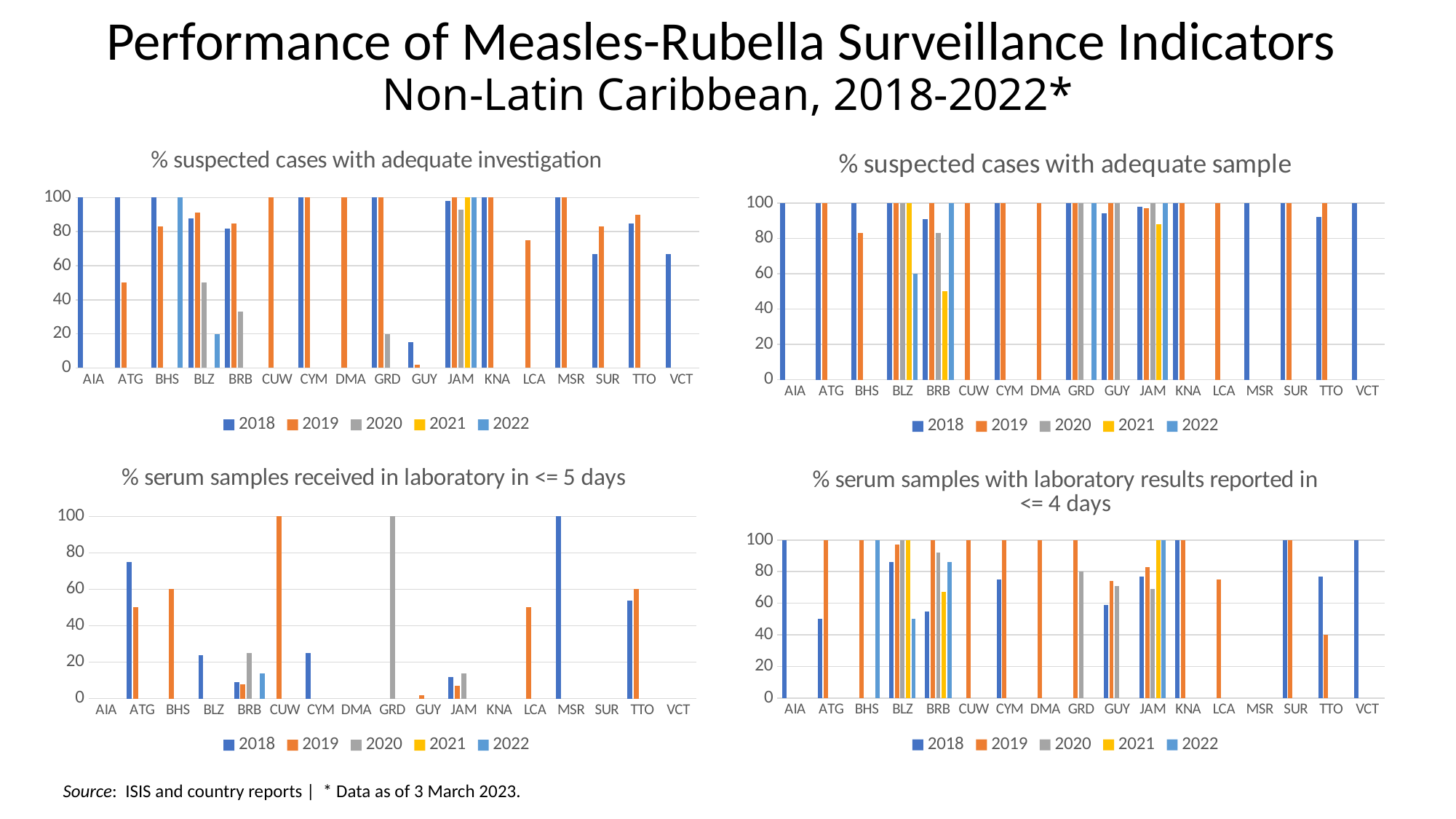
In "% serum samples received in laboratory in <= 5 days", what is the value for CUW in 2019? 100 In "% suspected cases with adequate investigation", what is the value for AIA in 2018? 100 In "% serum samples with laboratory results reported in <= 4 days", which country has the lowest 2019 value? TTO Which colour represents 2021 in the legends of the charts? yellow What kind of chart is "% suspected cases with adequate investigation"? bar chart In "% suspected cases with adequate investigation", which is larger for BRB: the 2018 value or the 2020 value? 2018 How many series does the legend of "% suspected cases with adequate sample" list? 5 How many countries are shown on the x axis of "% serum samples received in laboratory in <= 5 days"? 17 In "% serum samples received in laboratory in <= 5 days", which country has the highest 2018 value? MSR In "% suspected cases with adequate investigation", is the value for GUY in 2018 greater or less than 20? less In "% serum samples received in laboratory in <= 5 days", is the value for ATG in 2018 greater or less than 60? greater